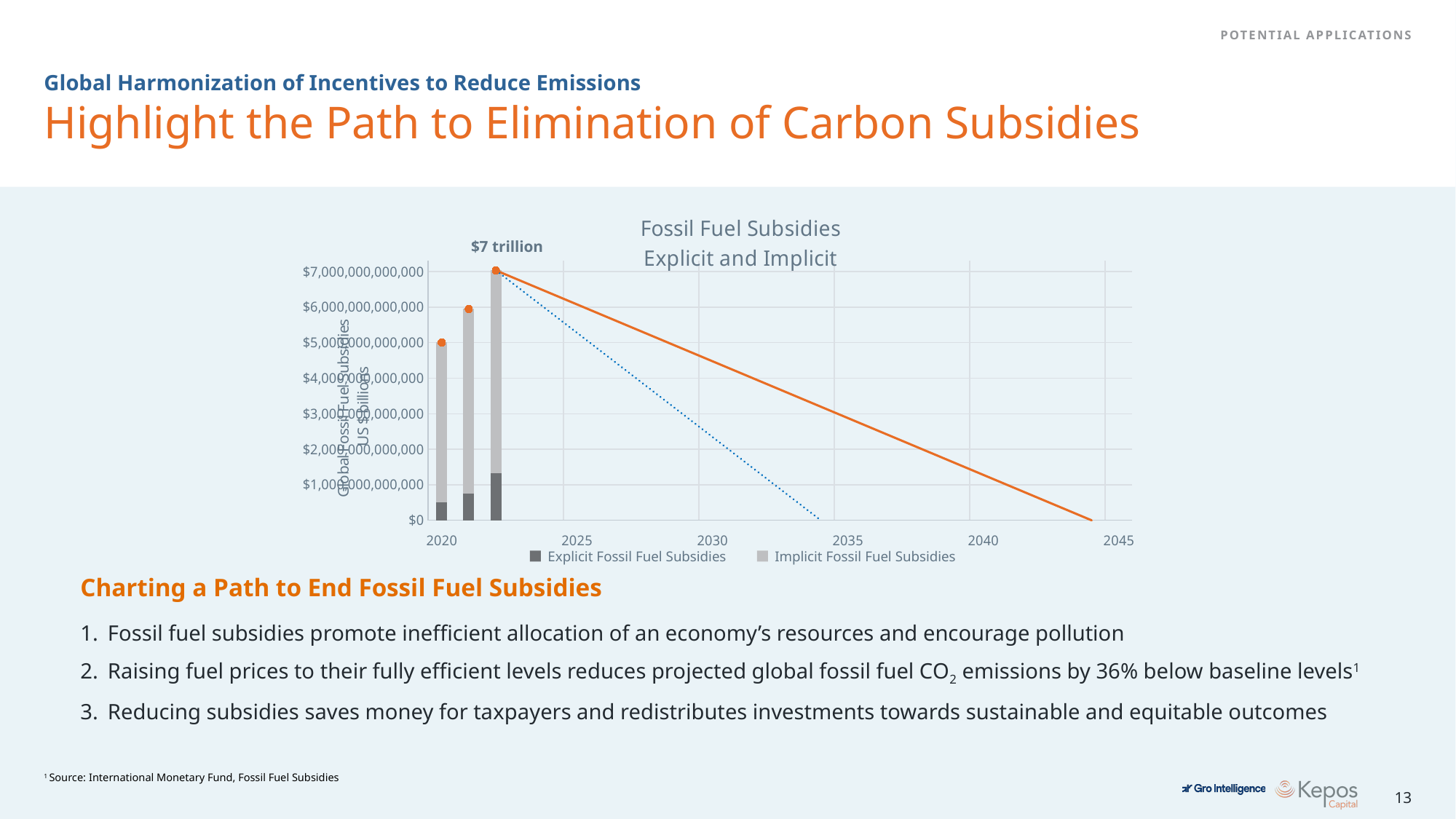
Is the total value for 2020 greater or less than $6,000,000,000,000? less Is the Explicit Fossil Fuel Subsidies value for 2022 greater or less than $2,000,000,000,000? less What is the title of the chart? Fossil Fuel Subsidies Explicit and Implicit Is the total value for 2021 greater or less than $5,000,000,000,000? greater Which year has the lowest total fossil fuel subsidies bar? 2020 In 2022, which is larger: Explicit Fossil Fuel Subsidies or Implicit Fossil Fuel Subsidies? Implicit Fossil Fuel Subsidies Do the total subsidy bars rise or fall from 2020 to 2022? rise What kind of chart is shown on the slide? combination bar and line chart How many bars are plotted in the chart? 3 What total value is annotated above the 2022 bar? $7 trillion How many series does the legend list? 2 Which year has the highest total fossil fuel subsidies bar? 2022